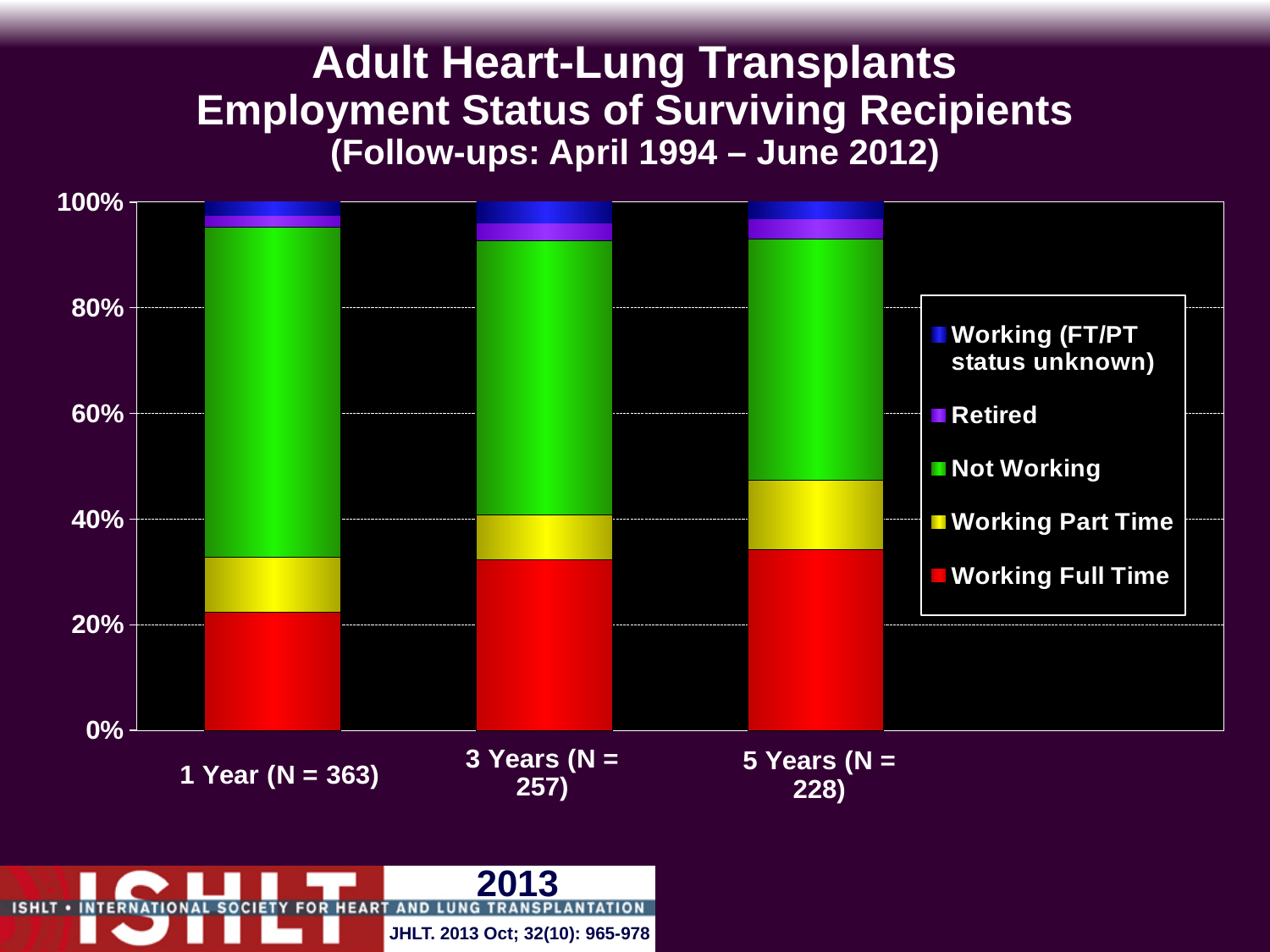
What does each stacked bar total? 100% How many follow-up time points (categories) are shown on the x axis? 3 Is the Working Full Time share at 3 Years greater or less than 20%? greater What is the N for the 1 Year follow-up group? 363 Which follow-up time point has the smallest Working Full Time segment? 1 Year (N = 363) How many series does the legend list? 5 Which is larger, the Working Full Time share at 1 Year or at 3 Years? 3 Years Does the Working Full Time share rise or fall from 1 Year to 5 Years? Rise Is the Not Working share at 5 Years greater or less than 60%? less What kind of chart is shown on the slide? Stacked bar chart Which follow-up time point has the largest Not Working segment? 1 Year (N = 363) Is the Working Full Time share at 1 Year greater or less than 40%? less